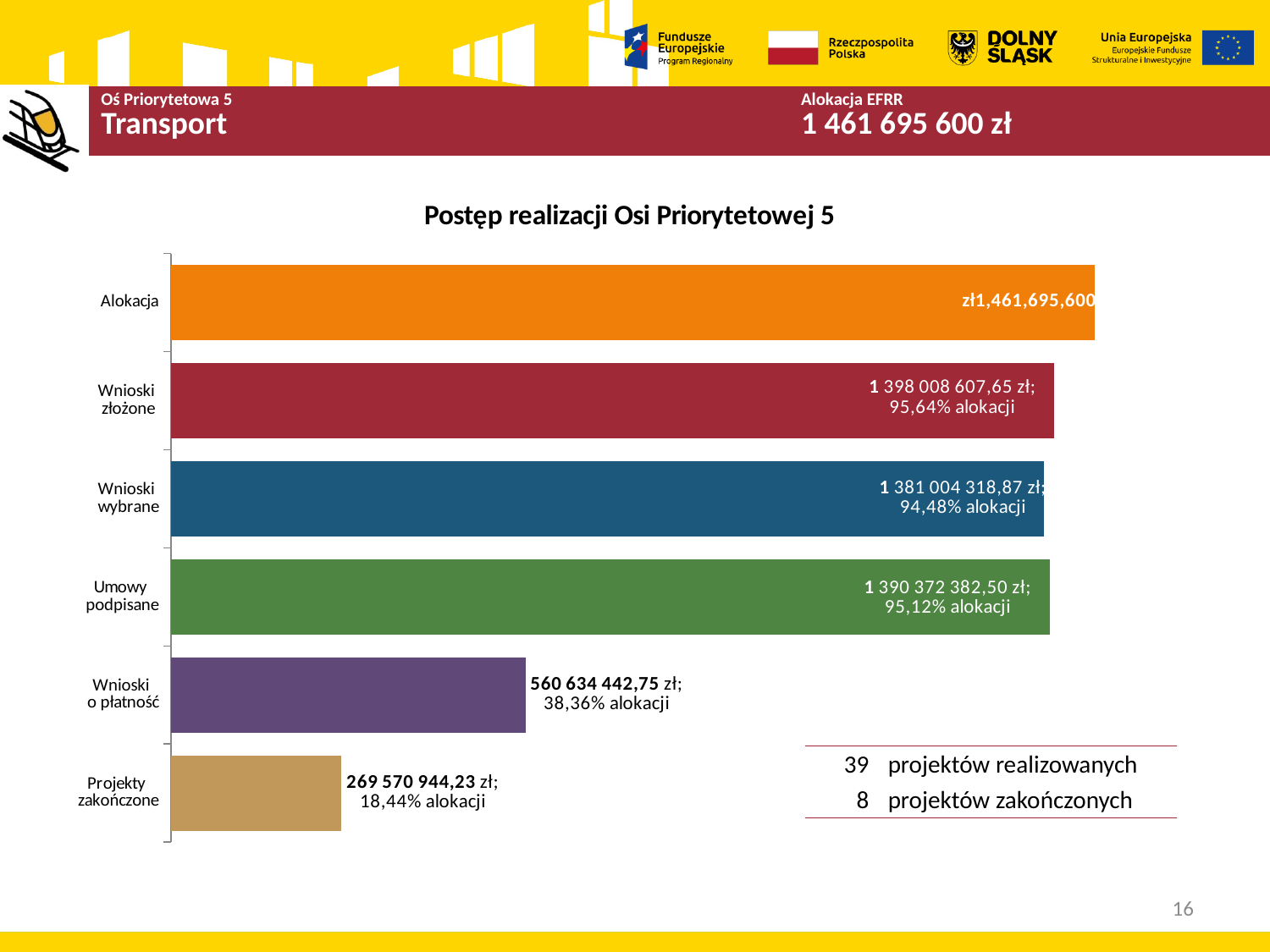
What percentage of the allocation do Umowy podpisane represent? 95,12% alokacji What value is shown for Alokacja? zł1,461,695,600 How many categories are plotted in the chart? 6 What is the title of the chart? Postęp realizacji Osi Priorytetowej 5 Which category has the lowest value in the chart? Projekty zakończone What amount is shown for Wnioski o płatność? 560 634 442,75 zł Which category has the highest value in the chart? Alokacja What type of chart is shown on the slide? Bar chart Which is larger, the value for Wnioski o płatność or for Projekty zakończone? Wnioski o płatność What percentage of the allocation do Projekty zakończone represent? 18,44% alokacji What is the difference in percentage of allocation between Wnioski o płatność and Projekty zakończone? 19,92 percentage points What amount is shown for Wnioski złożone? 1 398 008 607,65 zł